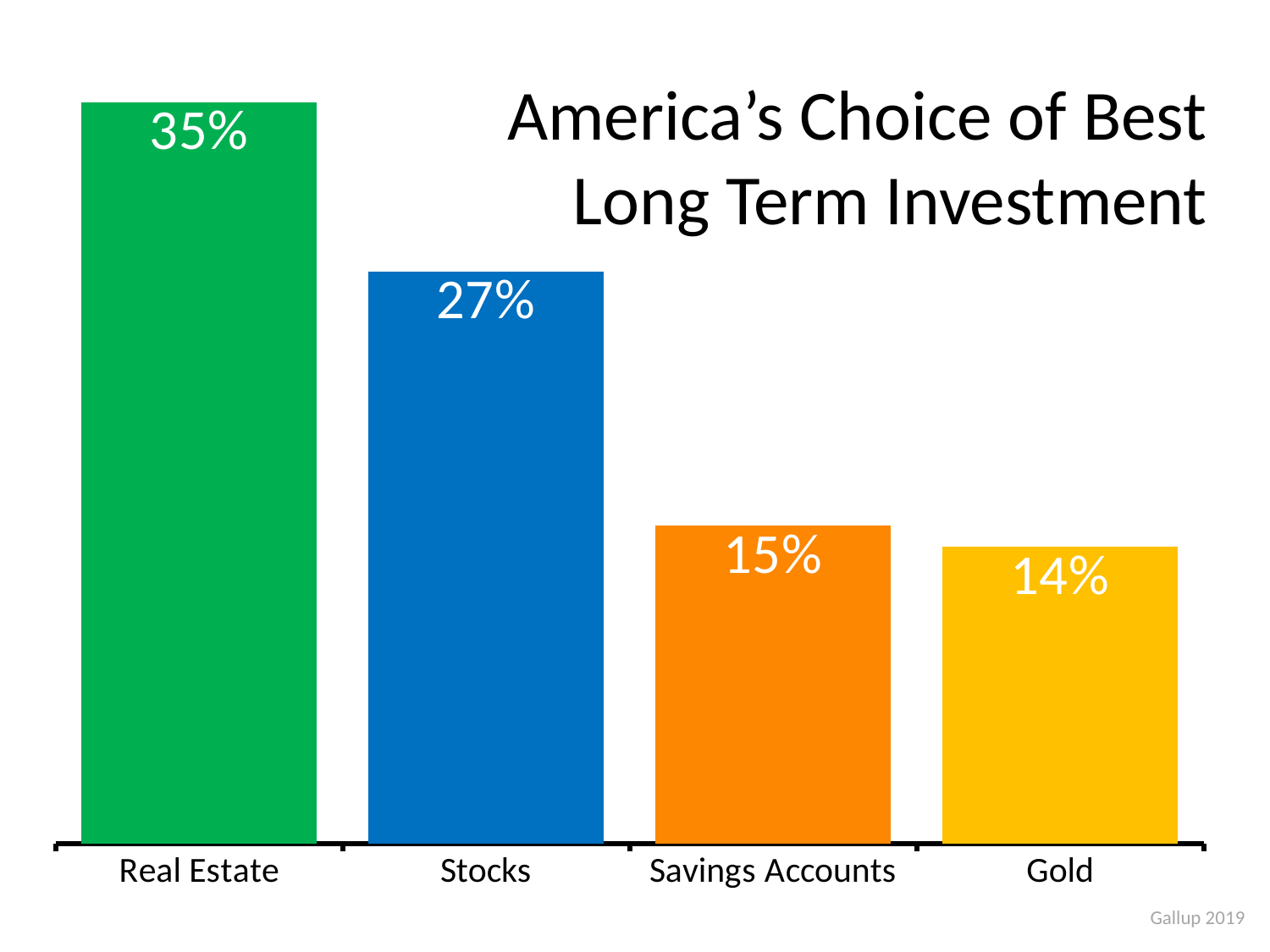
What is the difference between the values for Real Estate and Stocks? 8% What kind of chart is shown on the slide? Bar chart How many categories are shown in the chart? 4 What percentage of Americans chose Real Estate as the best long term investment? 35% What is the title of the chart? America's Choice of Best Long Term Investment Which category has the lowest value? Gold Which category has the highest value? Real Estate What is the value shown for Stocks? 27% What is the value shown for Savings Accounts? 15% Which is larger, the value for Stocks or the value for Gold? Stocks What is the value shown for Gold? 14% What is the difference between the values for Stocks and Savings Accounts? 12%